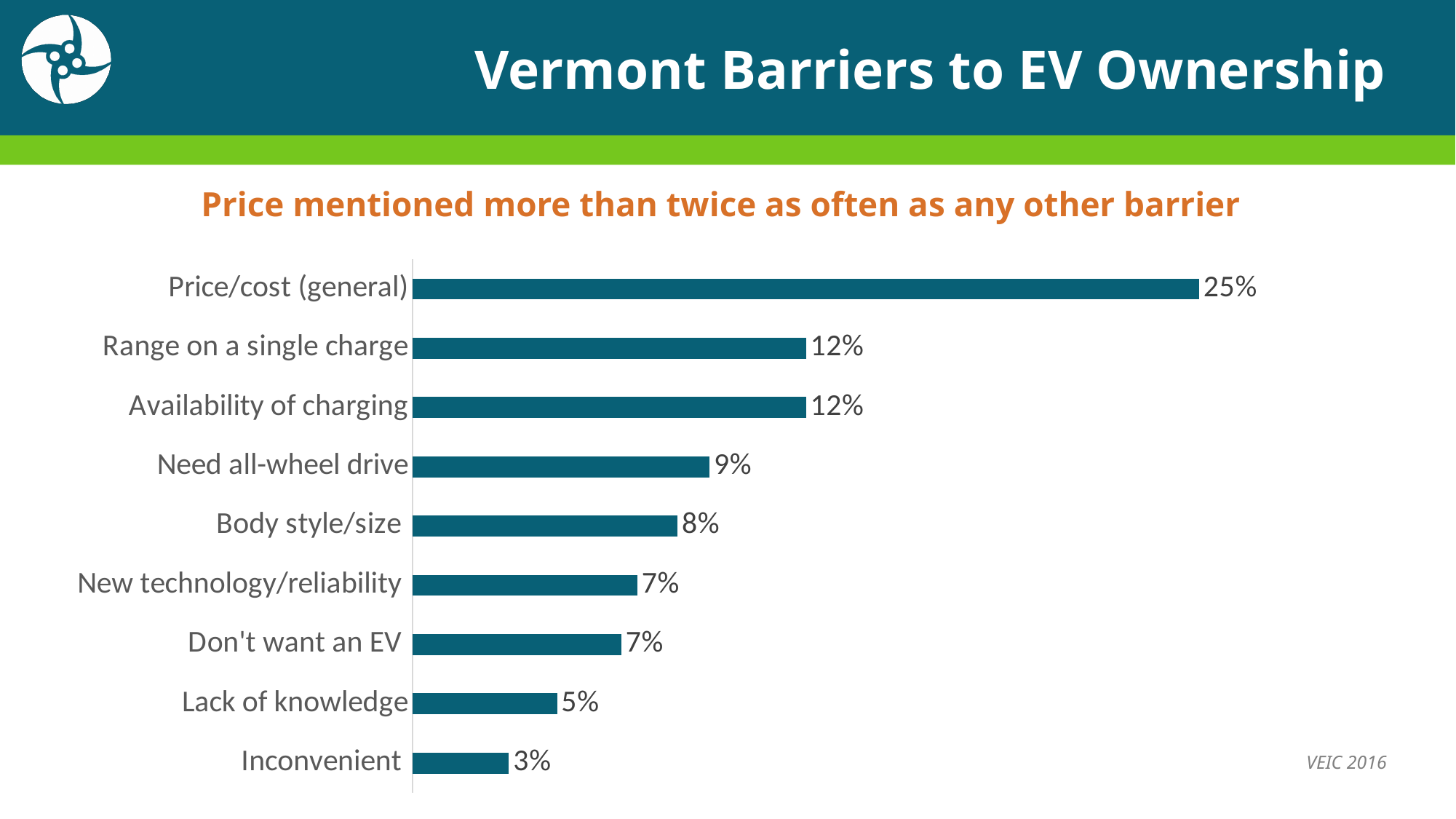
How many barriers are shown in the chart? 9 What is the difference between Body style/size and Lack of knowledge? 3% What kind of chart is shown on the slide? Bar chart What percentage of respondents mentioned Price/cost (general) as a barrier? 25% Which barrier has the lowest value? Inconvenient What is the value for Lack of knowledge? 5% Which barrier has the highest value? Price/cost (general) What is the difference between Price/cost (general) and Range on a single charge? 13% What is the value for Inconvenient? 3% What is the orange subtitle above the chart? Price mentioned more than twice as often as any other barrier What is the value for Need all-wheel drive? 9% Which is larger, Need all-wheel drive or Body style/size? Need all-wheel drive